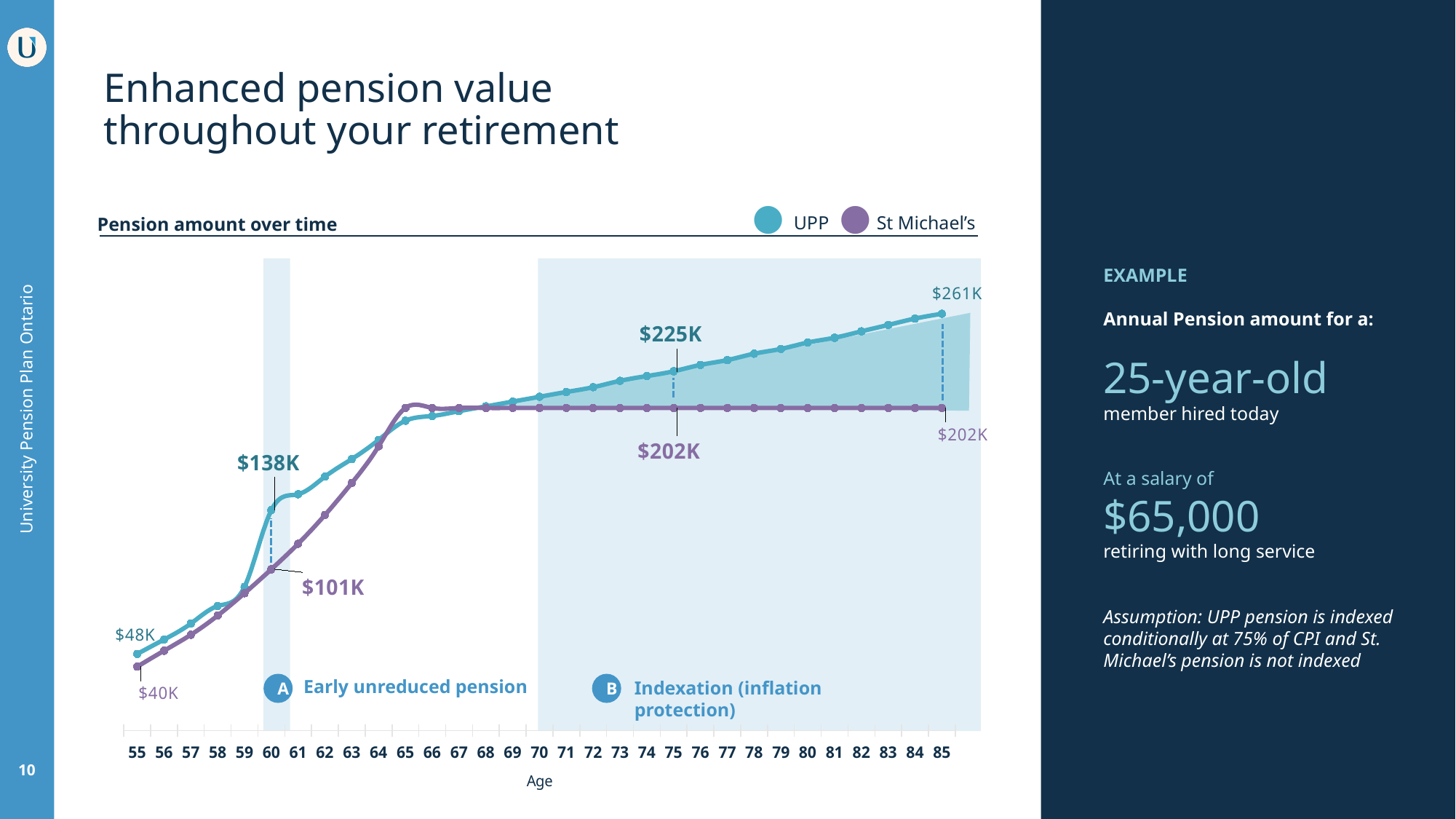
What is the title of the chart? Pension amount over time Does the UPP pension amount rise or fall from age 70 to age 85? Rise What is the St Michael's pension amount at age 85? $202K What is the St Michael's pension amount at age 60? $101K What is the UPP pension amount at age 60? $138K What is the difference between the UPP and St Michael's pension amounts at age 60? $37K How many series does the chart legend list? 2 What is the difference between the UPP and St Michael's pension amounts at age 85? $59K What is the UPP pension amount at age 55? $48K What type of chart is shown on the slide? Line chart At age 75, which series has the larger pension amount, UPP or St Michael's? UPP What is the UPP pension amount at age 85? $261K